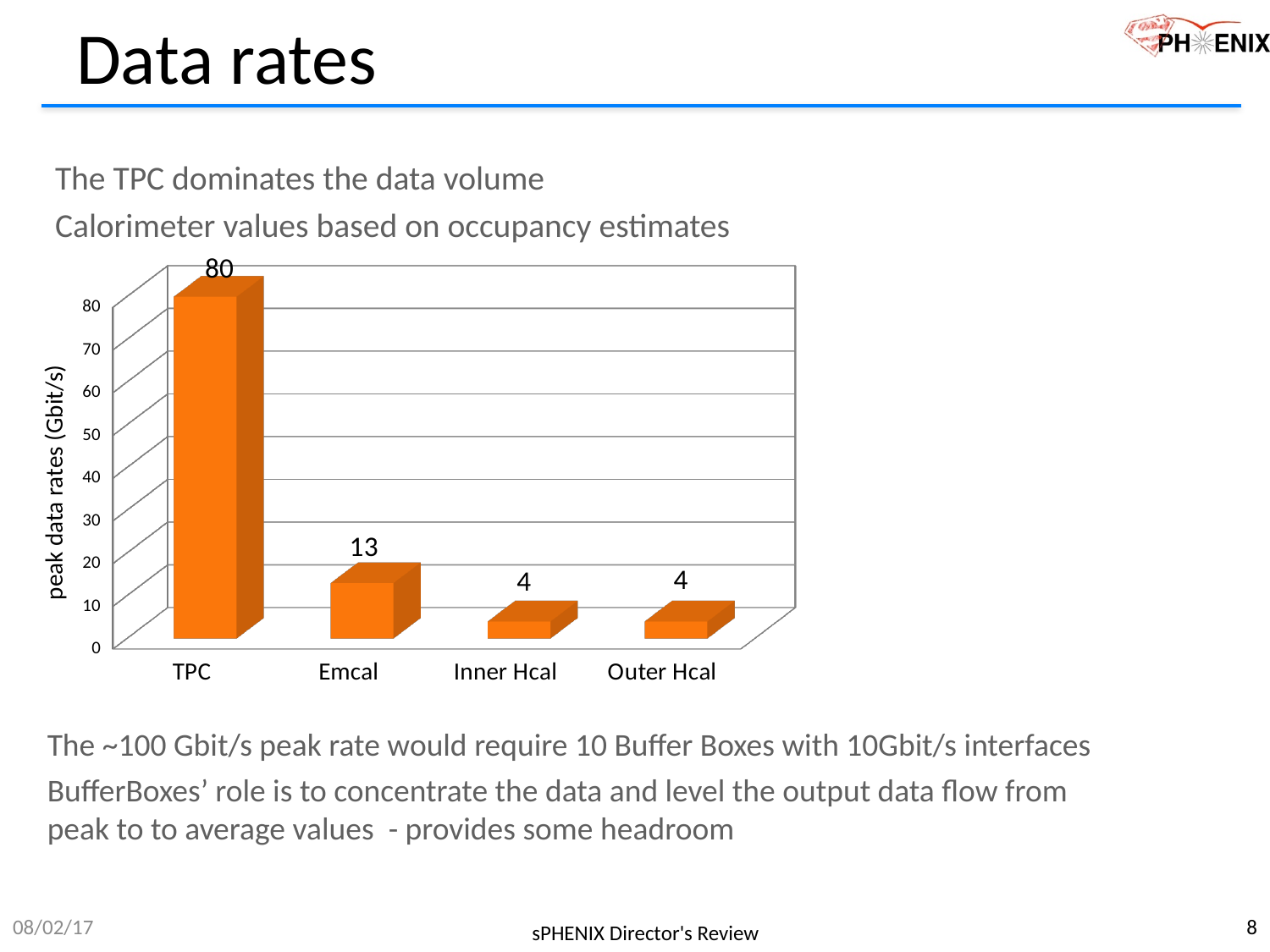
What is the peak data rate for Inner Hcal? 4 Which is larger, the peak data rate for Emcal or for Inner Hcal? Emcal What kind of chart is shown on the slide? bar chart What is the difference between the Emcal and Outer Hcal peak data rates? 9 What is the peak data rate for TPC? 80 What is the peak data rate for Emcal? 13 What is the label of the vertical axis of the chart? peak data rates (Gbit/s) How many categories are shown on the x axis of the chart? 4 What is the difference between the TPC and Emcal peak data rates? 67 Which category has the highest peak data rate? TPC What colour are the bars in the chart? orange Is the value for TPC greater or less than 70? greater